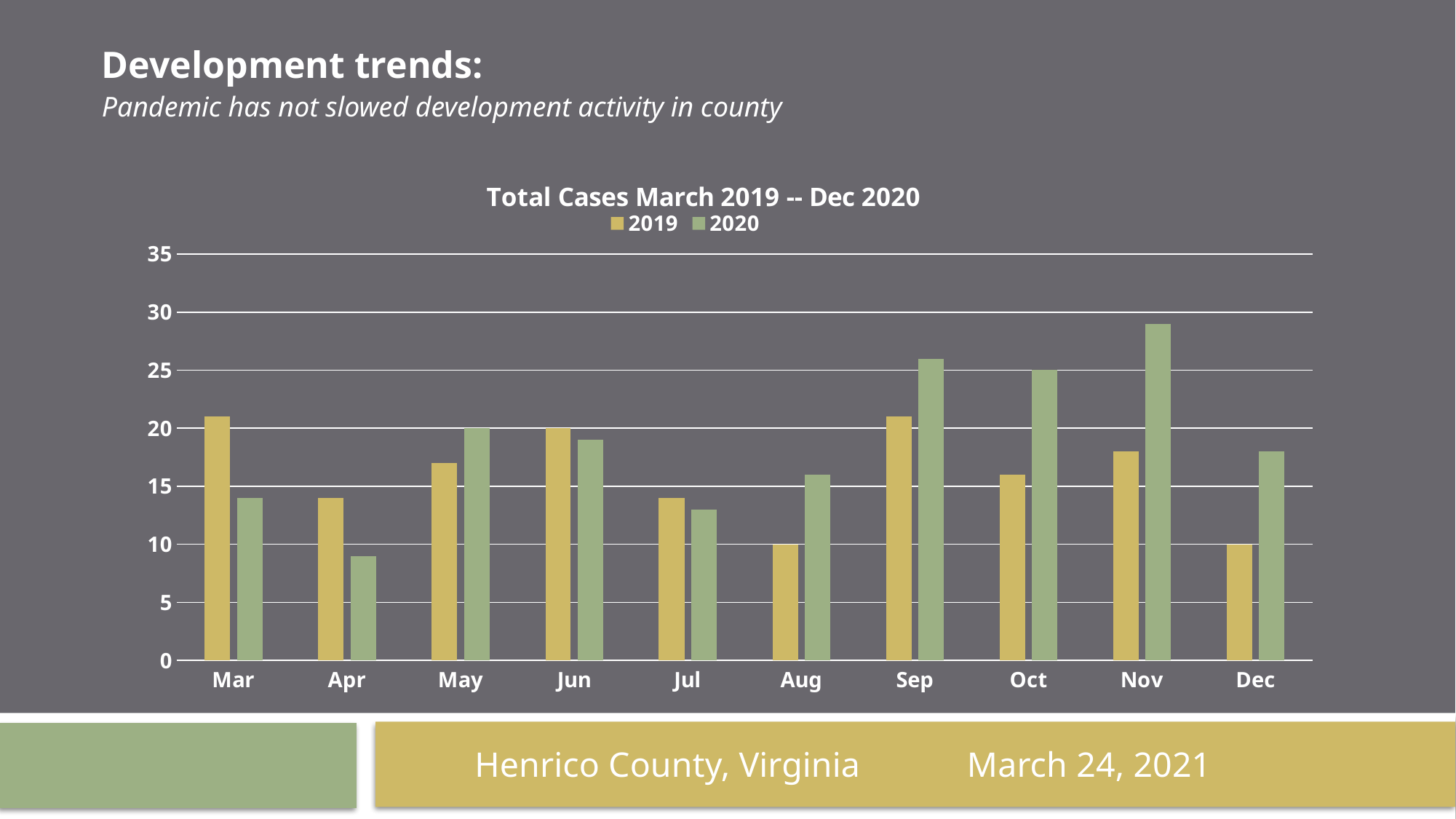
Which month has the highest 2020 value? Nov How many series does the legend list? 2 What kind of chart is shown on the slide? bar chart What is the 2020 value for Oct? 25 Which month has the lowest 2020 value? Apr What is the 2019 value for Jun? 20 What is the title of the chart? Total Cases March 2019 -- Dec 2020 How many months are shown on the x axis? 10 What is the 2019 value for Aug? 10 In Mar, which series has the larger value, 2019 or 2020? 2019 Is the 2020 value for Nov greater or less than 25? greater What is the 2020 value for May? 20